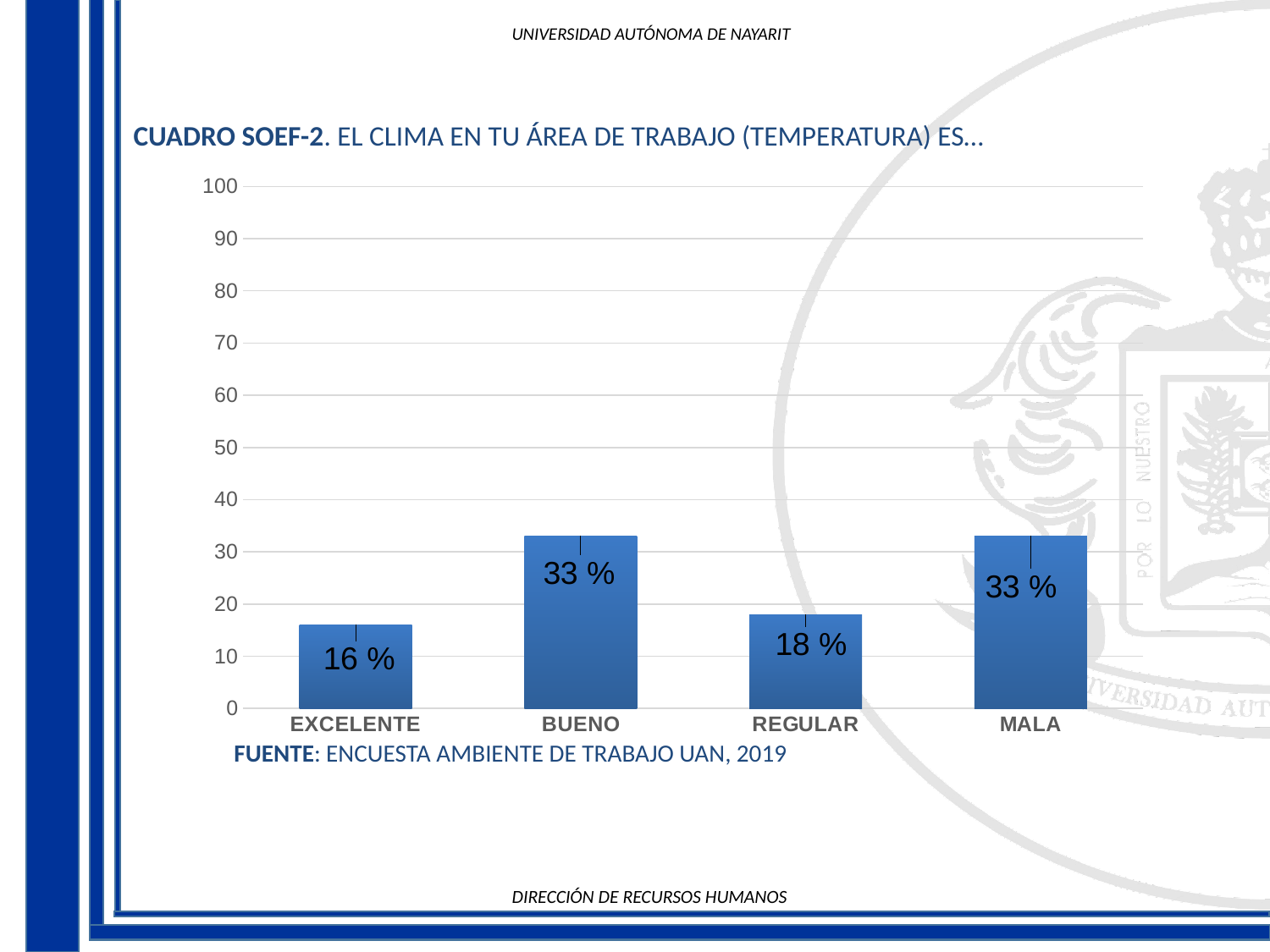
What is the value for EXCELENTE? 16 % What is the source cited below the chart? ENCUESTA AMBIENTE DE TRABAJO UAN, 2019 Is the value for MALA greater or less than 30? greater What is the value for REGULAR? 18 % What is the difference between the values for BUENO and EXCELENTE? 17 % Which is larger, the value for BUENO or the value for REGULAR? BUENO What kind of chart is shown on the slide? bar chart How many categories are shown on the x axis? 4 What is the value for BUENO? 33 % What is the difference between the values for REGULAR and EXCELENTE? 2 % Which category has the lowest value? EXCELENTE What is the value for MALA? 33 %